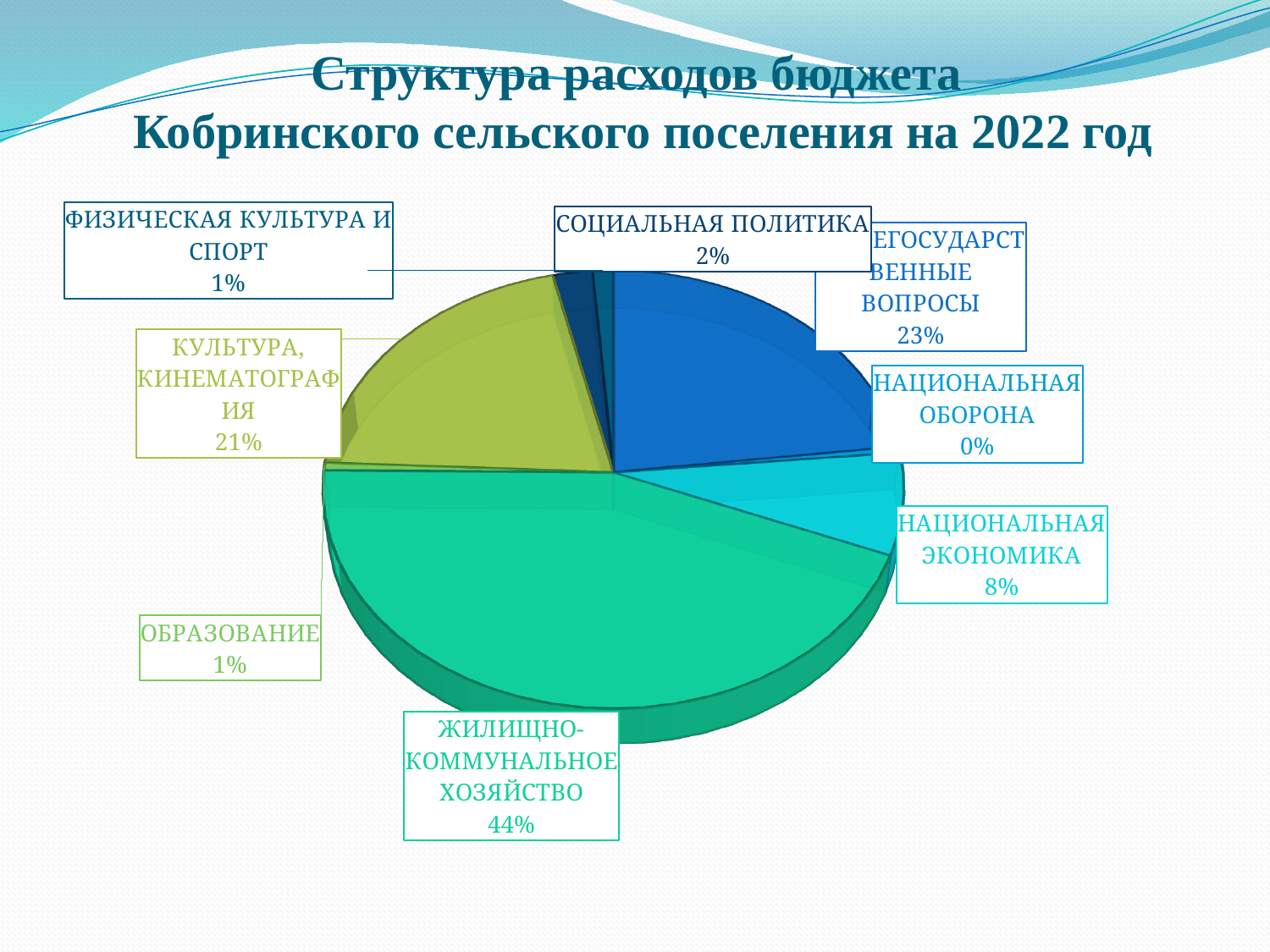
What year does the chart title say the budget expenditure structure is for? 2022 What kind of chart is shown on the slide? Pie chart Which category has the largest share of the pie? ЖИЛИЩНО-КОММУНАЛЬНОЕ ХОЗЯЙСТВО What percentage is shown for КУЛЬТУРА, КИНЕМАТОГРАФИЯ? 21% How many categories are labelled on the pie chart? 8 What percentage is shown for the slice labelled ЕГОСУДАРСТВЕННЫЕ ВОПРОСЫ? 23% What percentage is shown for НАЦИОНАЛЬНАЯ ЭКОНОМИКА? 8% Which category has the smallest share of the pie? НАЦИОНАЛЬНАЯ ОБОРОНА Which is larger: the share for НАЦИОНАЛЬНАЯ ЭКОНОМИКА or the share for СОЦИАЛЬНАЯ ПОЛИТИКА? НАЦИОНАЛЬНАЯ ЭКОНОМИКА What is the difference in percentage points between ЖИЛИЩНО-КОММУНАЛЬНОЕ ХОЗЯЙСТВО and КУЛЬТУРА, КИНЕМАТОГРАФИЯ? 23 What percentage is shown for СОЦИАЛЬНАЯ ПОЛИТИКА? 2% What share of the pie does ЖИЛИЩНО-КОММУНАЛЬНОЕ ХОЗЯЙСТВО have? 44%